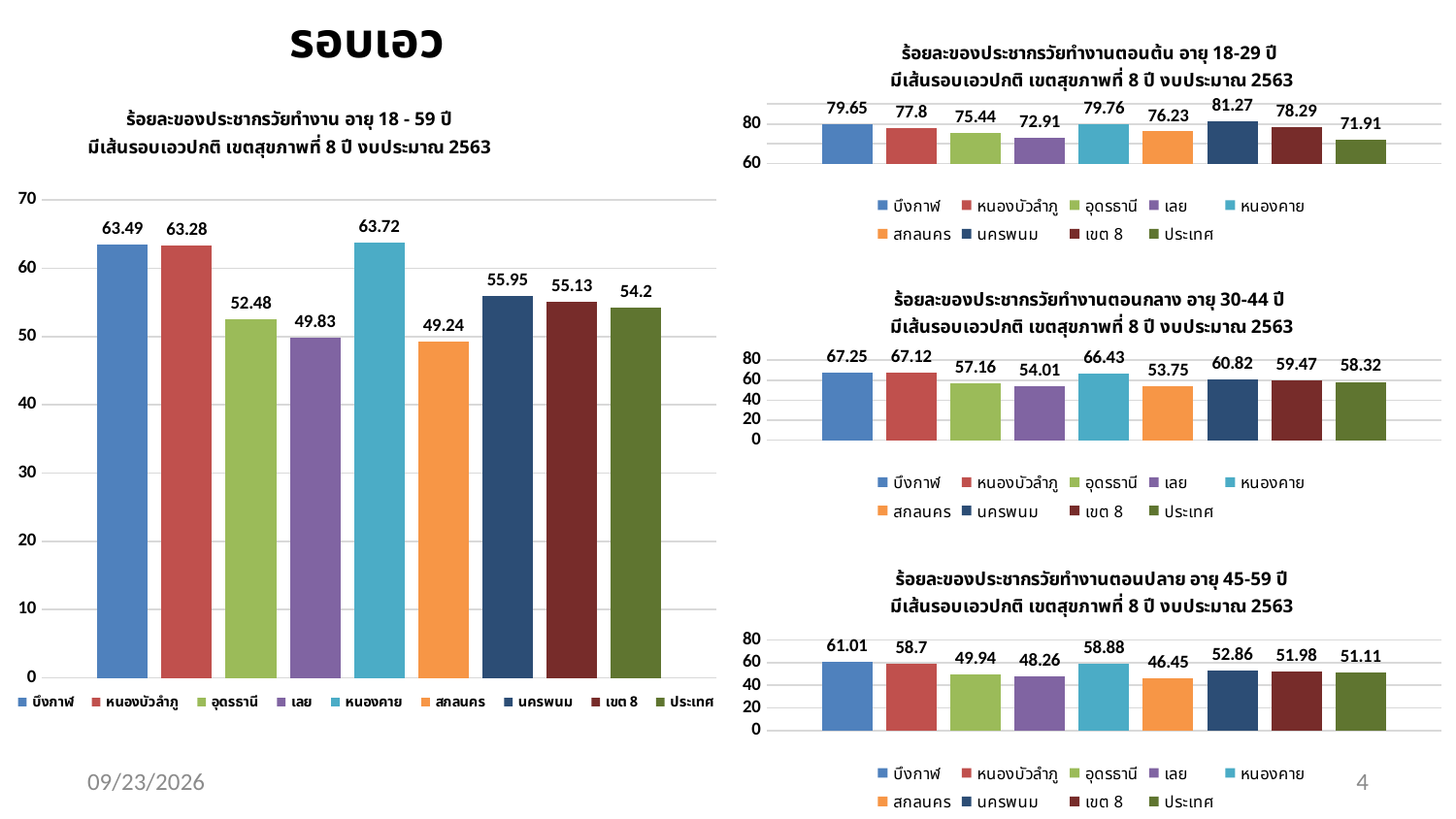
In the large chart on the left (ages 18 - 59), what is the difference between the values for นครพนม and เขต 8? 0.82 What type of chart is the large chart on the left? Bar chart In the middle-right chart (ages 30-44), what is the value for สกลนคร? 53.75 In the large chart on the left (ages 18 - 59), how many categories are plotted? 9 In the large chart on the left (ages 18 - 59), which category has the lowest value? สกลนคร In the bottom-right chart (ages 45-59), what is the difference between the values for บึงกาฬ and สกลนคร? 14.56 In the top-right chart (ages 18-29), what is the value for นครพนม? 81.27 In the bottom-right chart (ages 45-59), what is the value for บึงกาฬ? 61.01 In the large chart on the left (ages 18 - 59), which category has the highest value? หนองคาย In the large chart on the left (ages 18 - 59), what is the value for หนองคาย? 63.72 In the top-right chart (ages 18-29), which category has the lowest value? ประเทศ In the middle-right chart (ages 30-44), which is larger, the value for เขต 8 or the value for ประเทศ? เขต 8